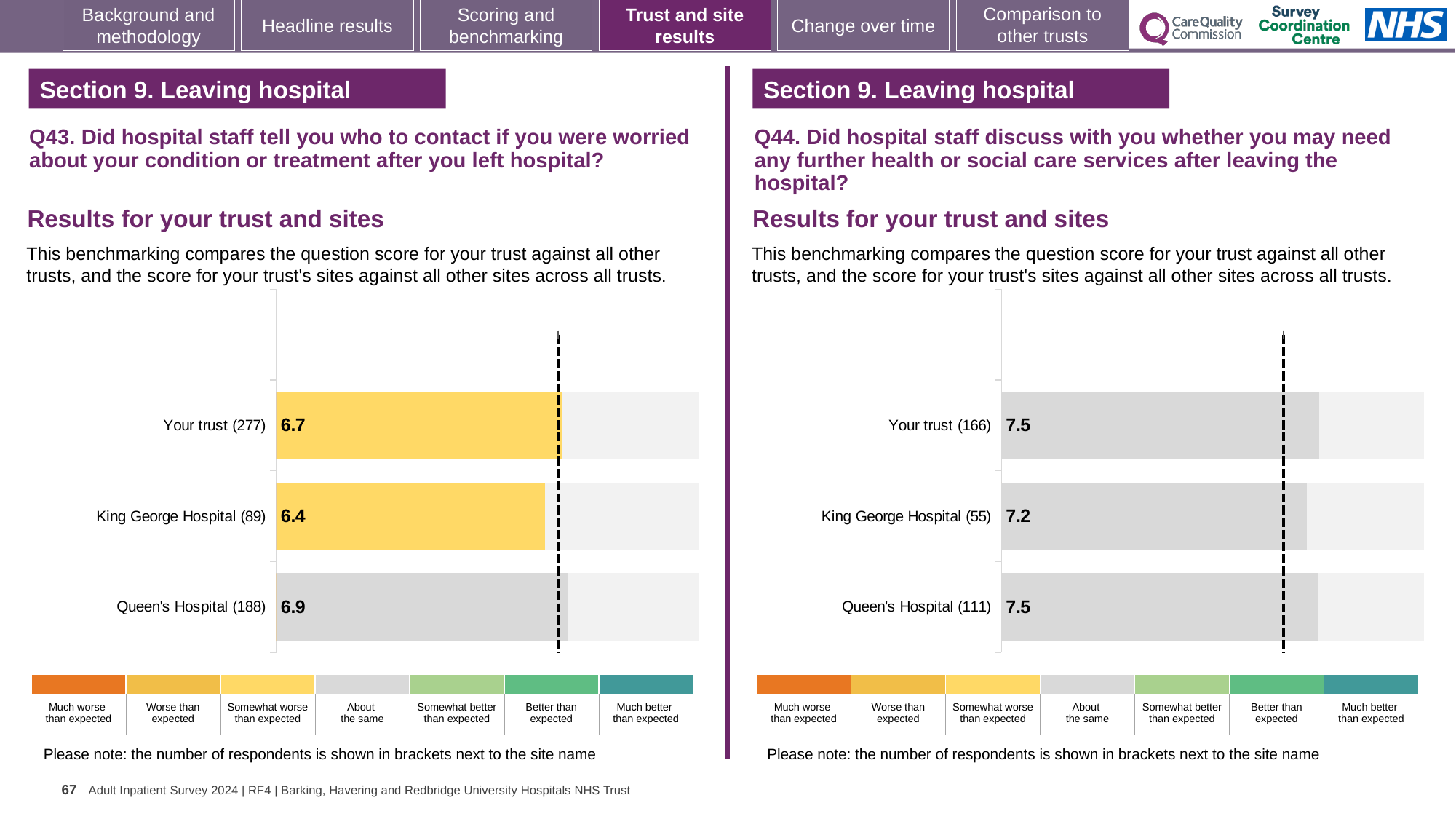
In the Q43 chart on the left, what is the score for King George Hospital? 6.4 In the Q43 chart on the left, what is the score for Your trust? 6.7 In the Q43 chart on the left, which site or trust has the lowest score? King George Hospital In the Q44 chart on the right, what is the score for King George Hospital? 7.2 What type of chart is used in the Q44 chart on the right? Bar chart In the Q43 chart on the left, how many bars are plotted? 3 In the Q44 chart on the right, which site has the lowest score? King George Hospital In the Q43 chart on the left, how many respondents are shown in brackets for Queen's Hospital? 188 In the Q44 chart on the right, what is the difference between the scores for Your trust and King George Hospital? 0.3 In the Q43 chart on the left, which site or trust has the highest score? Queen's Hospital In the Q44 chart on the right, what is the score for Queen's Hospital? 7.5 In the Q43 chart on the left, what is the difference between the scores for Queen's Hospital and King George Hospital? 0.5